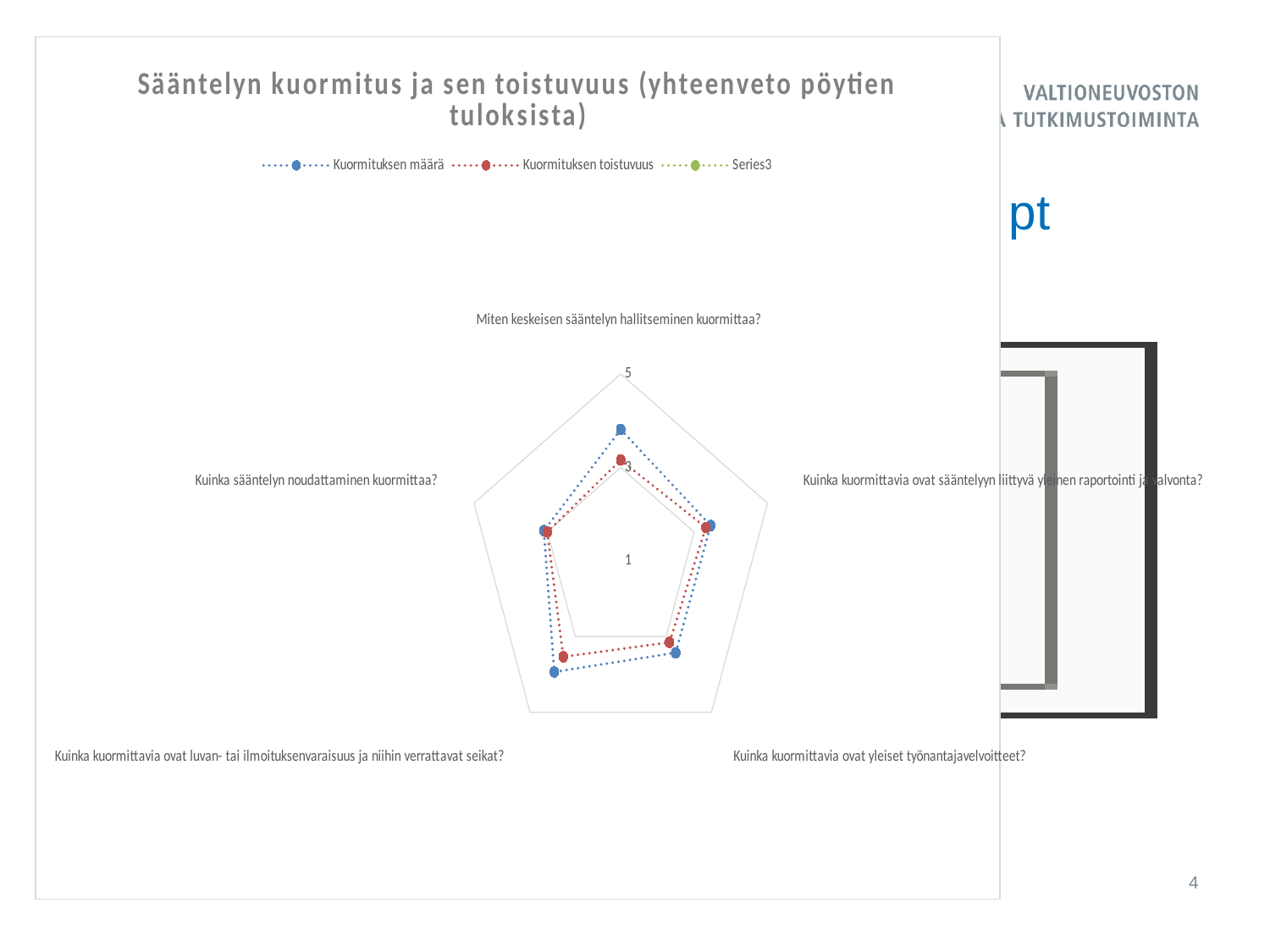
How many categories (axes) does the radar chart have? 5 What kind of chart is shown on the slide? Radar chart Is the value of Kuormituksen määrä for "Miten keskeisen sääntelyn hallitseminen kuormittaa?" greater or less than 5? less How many series does the legend list? 3 What is the name of the third series in the legend? Series3 Is the value of Kuormituksen toistuvuus for "Kuinka kuormittavia ovat luvan- tai ilmoituksenvaraisuus ja niihin verrattavat seikat?" greater or less than 3? greater What is the title of the chart? Sääntelyn kuormitus ja sen toistuvuus (yhteenveto pöytien tuloksista) Is the value of Kuormituksen määrä for "Miten keskeisen sääntelyn hallitseminen kuormittaa?" greater or less than 3? greater For "Kuinka kuormittavia ovat luvan- tai ilmoituksenvaraisuus ja niihin verrattavat seikat?", which series has the larger value, Kuormituksen määrä or Kuormituksen toistuvuus? Kuormituksen määrä What is the highest value shown on the radar chart's axis scale? 5 For "Miten keskeisen sääntelyn hallitseminen kuormittaa?", which series has the larger value, Kuormituksen määrä or Kuormituksen toistuvuus? Kuormituksen määrä